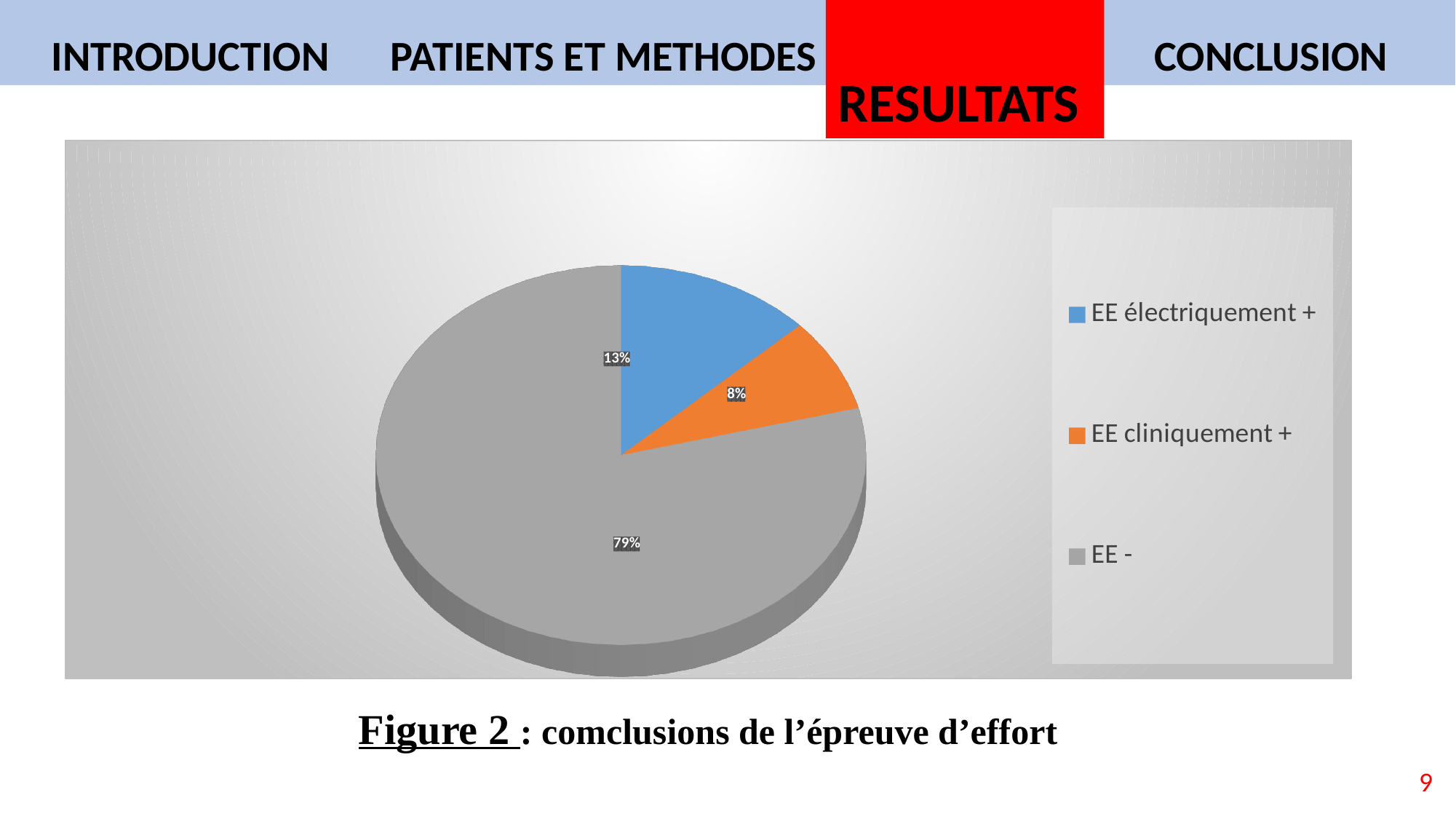
What is the caption of the figure shown on the slide? Figure 2 : comclusions de l'épreuve d'effort How many slices does the pie chart have? 3 What colour is the 'EE cliniquement +' slice in the pie chart? Orange What share of the pie does the 'EE électriquement +' slice represent? 13% What share of the pie does the 'EE -' slice represent? 79% What kind of chart is shown on the slide? Pie chart Which is larger, the 'EE électriquement +' slice or the 'EE cliniquement +' slice? EE électriquement + Which category has the smallest slice of the pie? EE cliniquement + What share of the pie does the 'EE cliniquement +' slice represent? 8% Which category has the largest slice of the pie? EE - What is the difference in percentage points between the 'EE -' slice and the 'EE électriquement +' slice? 66 What is the difference in percentage points between the 'EE électriquement +' slice and the 'EE cliniquement +' slice? 5